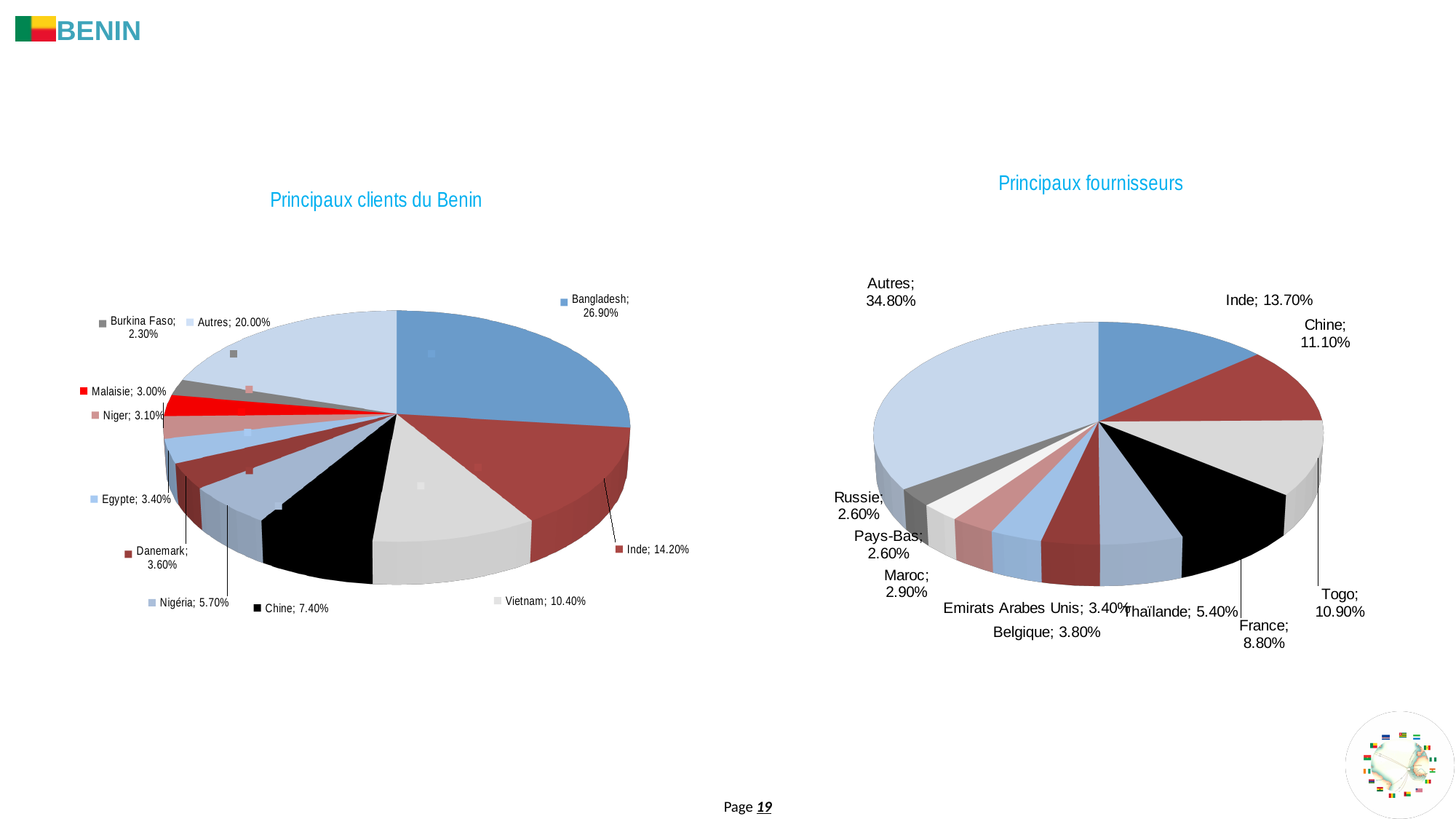
In the 'Principaux fournisseurs' chart, what is the value for Togo? 10.90% In the 'Principaux fournisseurs' chart, what share does Autres have? 34.80% In the 'Principaux fournisseurs' chart, which is larger, Thaïlande or Belgique? Thaïlande In the 'Principaux clients du Benin' chart, which is larger, Nigéria or Danemark? Nigéria In the 'Principaux clients du Benin' chart, what share does Bangladesh have? 26.90% In the 'Principaux clients du Benin' chart, what is the difference between Inde and Chine? 6.80% In the 'Principaux clients du Benin' chart, what is the value for Vietnam? 10.40% How many slices does the 'Principaux clients du Benin' pie chart have? 11 In the 'Principaux clients du Benin' chart, which named country (excluding Autres) has the smallest share? Burkina Faso In the 'Principaux fournisseurs' chart, which named country (excluding Autres) has the largest share? Inde In the 'Principaux fournisseurs' chart, what is the difference between Chine and France? 2.30% What type of chart is used for 'Principaux fournisseurs'? Pie chart